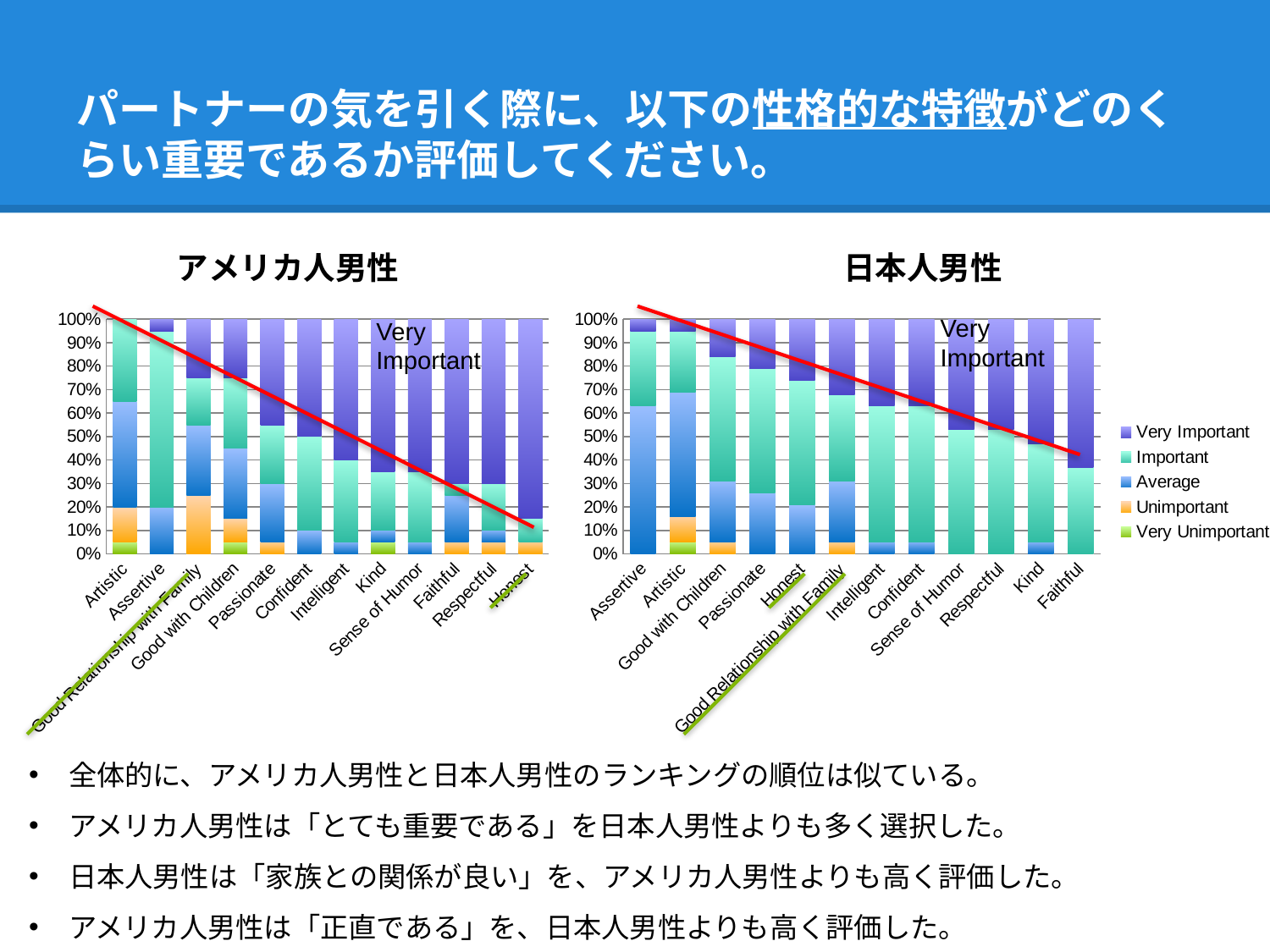
What kind of chart is used for the アメリカ人男性 chart? Stacked bar chart Which chart shows a larger Very Important share for Honest, アメリカ人男性 or 日本人男性? アメリカ人男性 In the アメリカ人男性 chart, which category has the largest Very Important share? Honest Which legend entry is listed first in the legend? Very Important In the アメリカ人男性 chart, does the Very Important share rise or fall from left to right along the x axis? rise How many categories are shown on the x axis of the アメリカ人男性 chart? 12 In the アメリカ人男性 chart, is the Very Important share for Honest greater or less than 80%? greater How many series does the legend list? 5 In the 日本人男性 chart, which category has the largest Very Important share? Faithful In the 日本人男性 chart, is the Very Important share for Faithful greater or less than 50%? greater How many categories are shown on the x axis of the 日本人男性 chart? 12 In the 日本人男性 chart, which category has the largest Unimportant share? Artistic